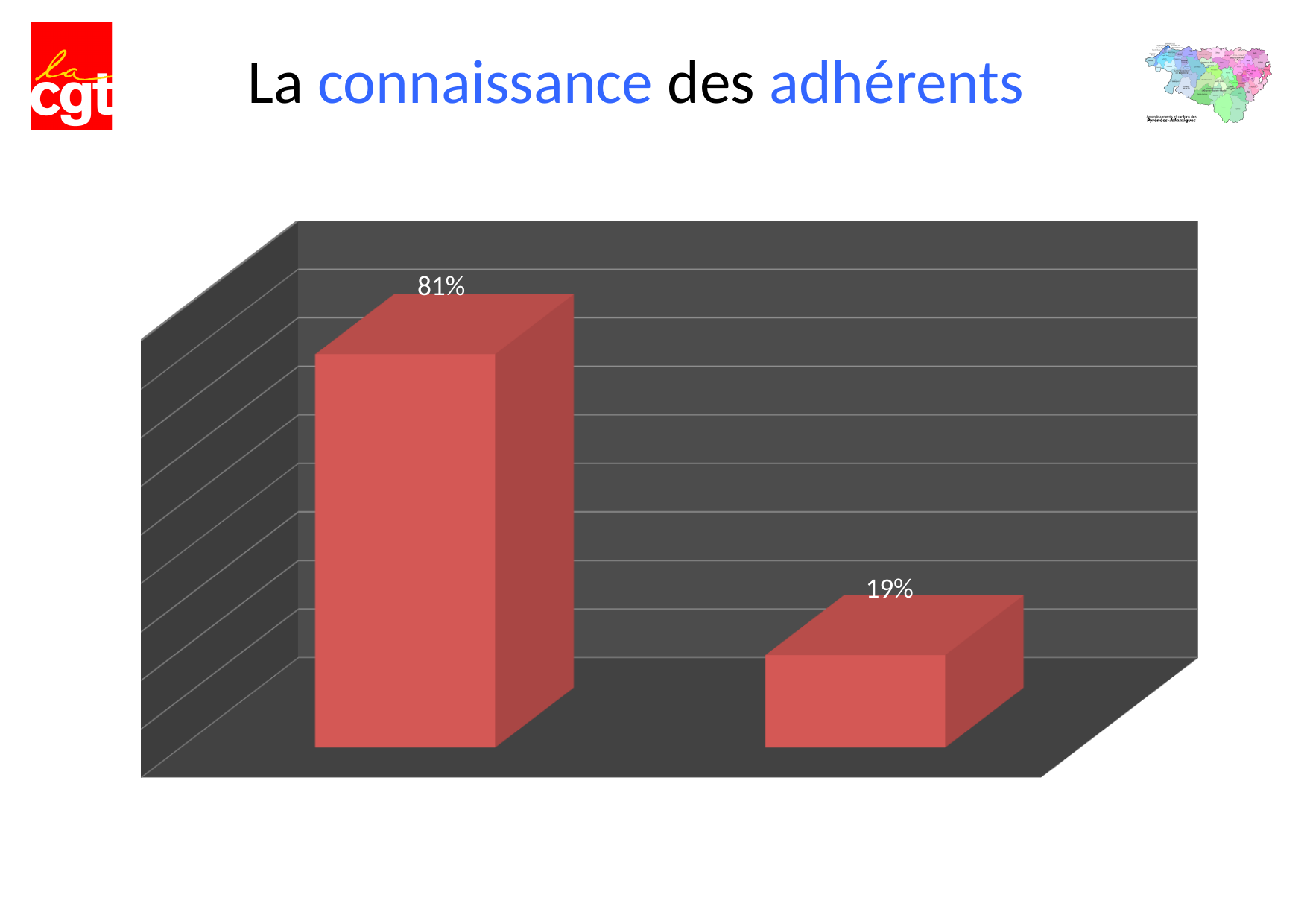
What colour are the bars in the chart? red Is the value of the left bar larger or smaller than the value of the right bar? larger Which bar has the highest value, the left or the right one? the left bar How many bars are plotted in the chart? 2 Do the values rise or fall from the left bar to the right bar? fall What kind of chart is shown on the slide? bar chart What is the title of the slide containing the chart? La connaissance des adhérents Which bar has the lowest value, the left or the right one? the right bar What value is shown on the left bar of the chart? 81% What do the two bar values add up to? 100% What value is shown on the right bar of the chart? 19% What is the difference between the left bar's value and the right bar's value? 62 percentage points